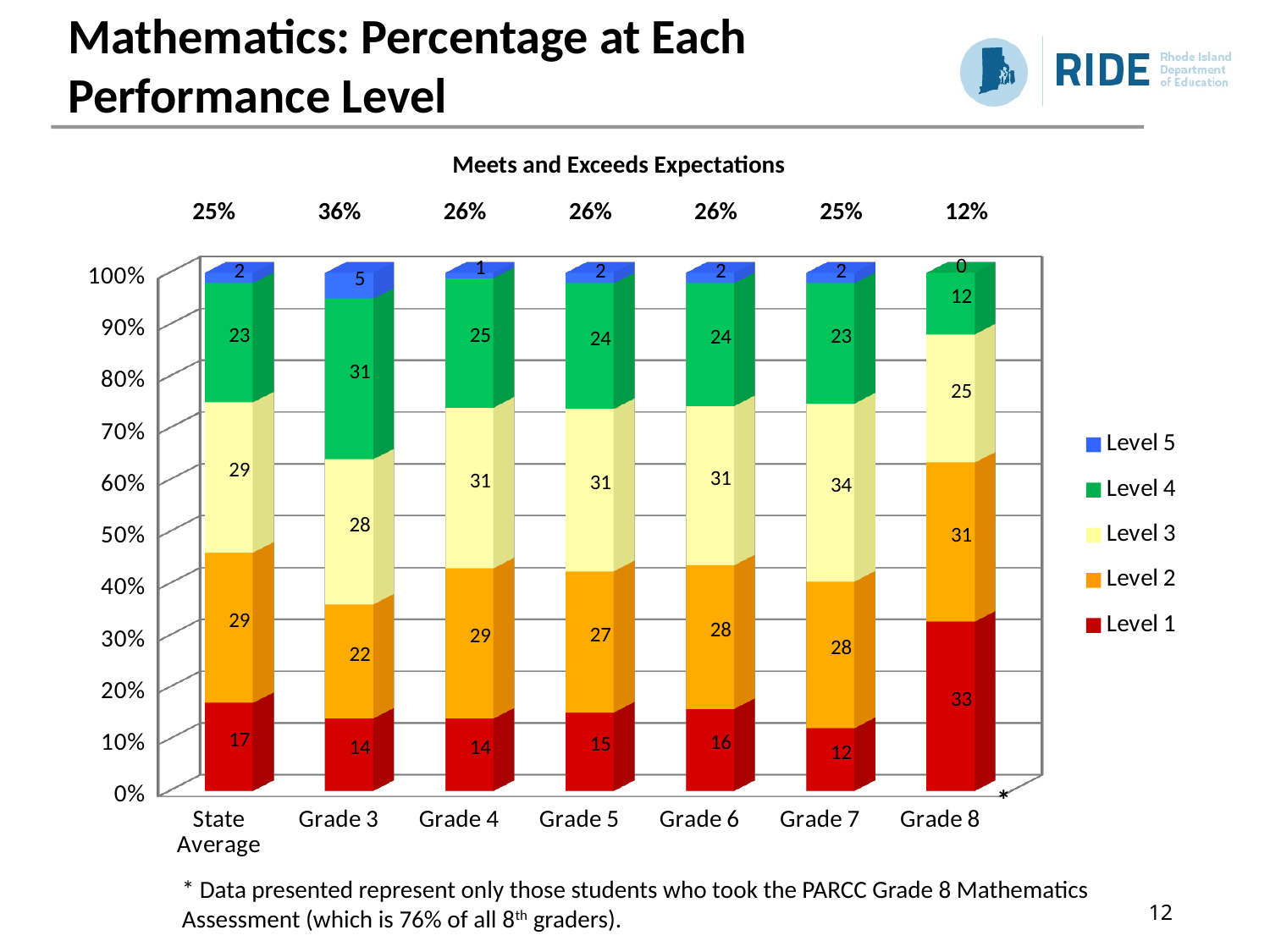
How many series does the legend list? 5 Which category has the lowest Level 1 value? Grade 7 What is the Level 5 value for Grade 8? 0 What is the difference between the Level 2 value for State Average and the Level 2 value for Grade 3? 7 What is the Level 4 value for Grade 3? 31 Which is larger, the Level 4 value for Grade 4 or the Level 4 value for Grade 8? Grade 4 What is the Level 3 value for Grade 7? 34 Which category has the highest Level 1 value? Grade 8 What is the Level 1 value for Grade 8? 33 What is the Meets and Exceeds Expectations percentage shown above Grade 3? 36% How many categories are shown on the x axis? 7 What kind of chart is shown on the slide? Stacked bar chart